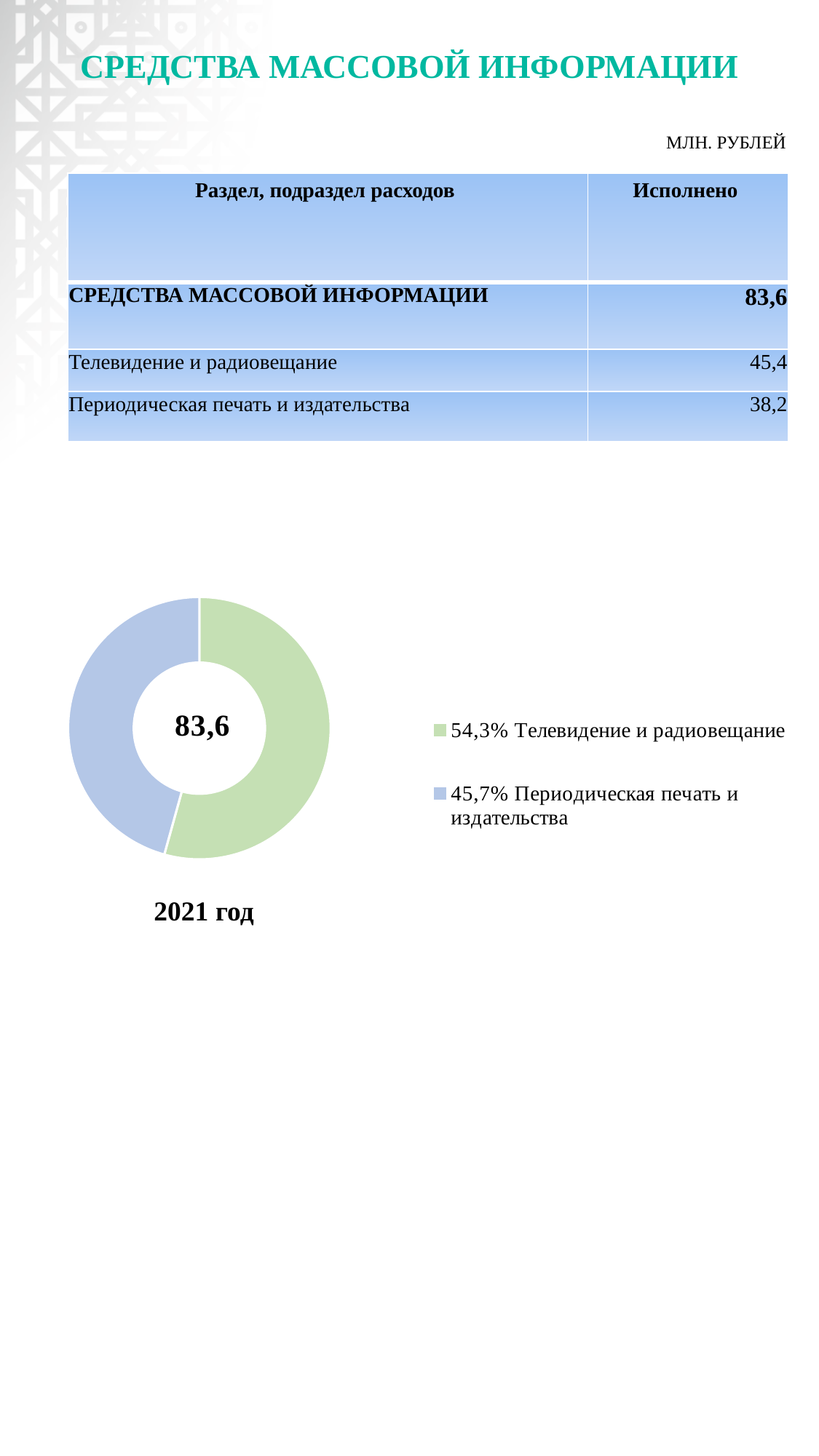
Is the share for Телевидение и радиовещание greater or less than 50%? greater Which slice of the doughnut chart is the largest? Телевидение и радиовещание What colour is the Периодическая печать и издательства slice in the doughnut chart? Blue What share of the doughnut chart does Периодическая печать и издательства take? 45,7% What kind of chart is shown on the slide? Doughnut (pie) chart What share of the doughnut chart does Телевидение и радиовещание take? 54,3% Which slice of the doughnut chart is the smallest? Периодическая печать и издательства How many slices does the doughnut chart have? 2 What total value is shown in the centre of the doughnut chart? 83,6 Which is larger in the doughnut chart: Телевидение и радиовещание or Периодическая печать и издательства? Телевидение и радиовещание Which year is labelled under the doughnut chart? 2021 год What is the difference in percentage points between the two slices of the doughnut chart? 8,6